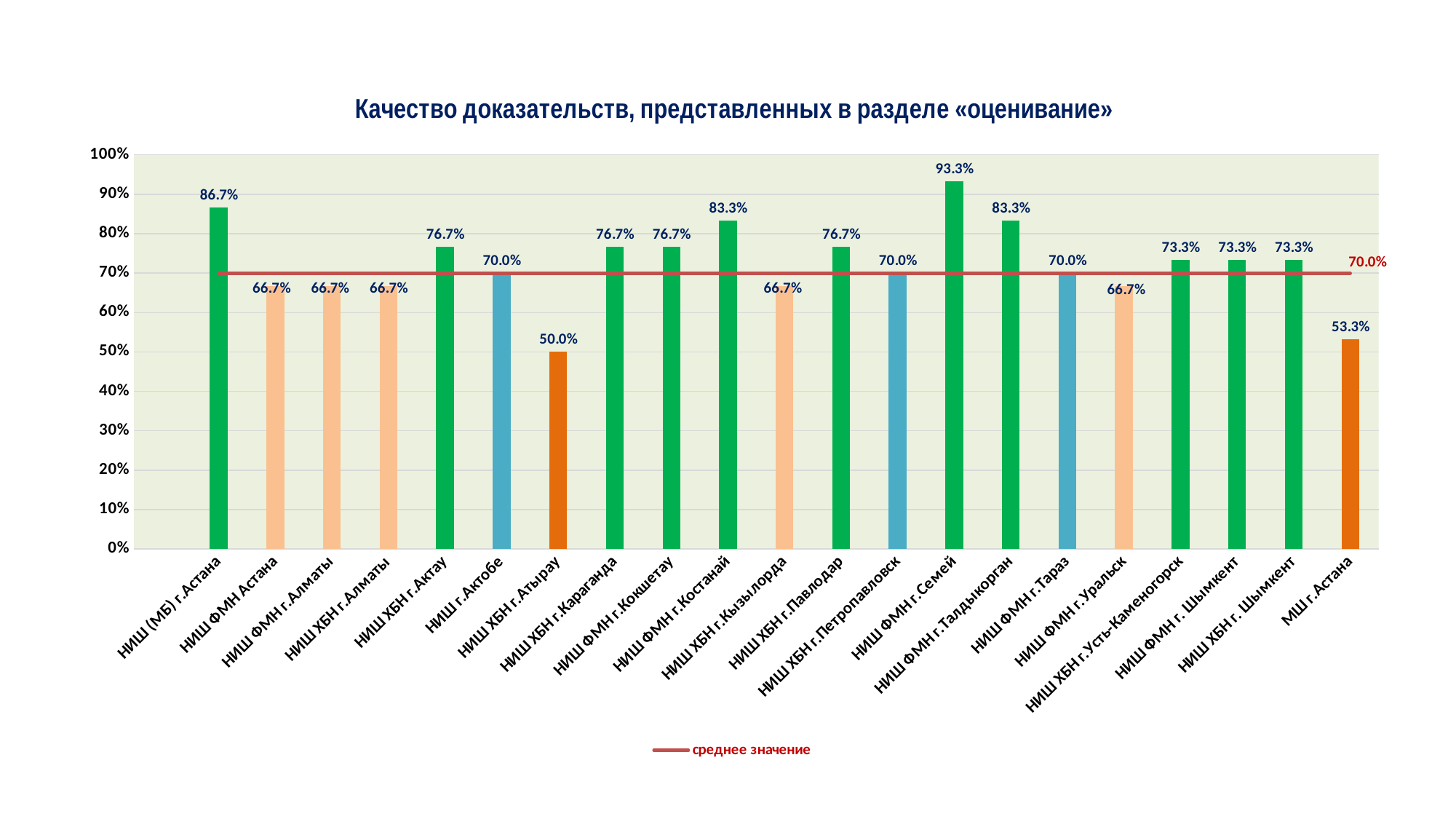
Which category has the highest value? НИШ ФМН г.Семей What is the difference between the values for НИШ (МБ) г.Астана and НИШ ФМН Астана? 20.0% What is the value for МШ г.Астана? 53.3% What is the value for НИШ ХБН г.Атырау? 50.0% What is the value for НИШ ФМН г.Семей? 93.3% What value does the horizontal line labelled 'среднее значение' mark? 70.0% Which is larger, the value for НИШ ФМН г.Костанай or the value for НИШ ХБН г.Усть-Каменогорск? НИШ ФМН г.Костанай How many categories are shown on the x axis? 21 Is the value for НИШ ХБН г.Кызылорда greater or less than 70%? less Which category has the lowest value? НИШ ХБН г.Атырау What kind of chart is this? bar chart What is the title of the chart? Качество доказательств, представленных в разделе «оценивание»